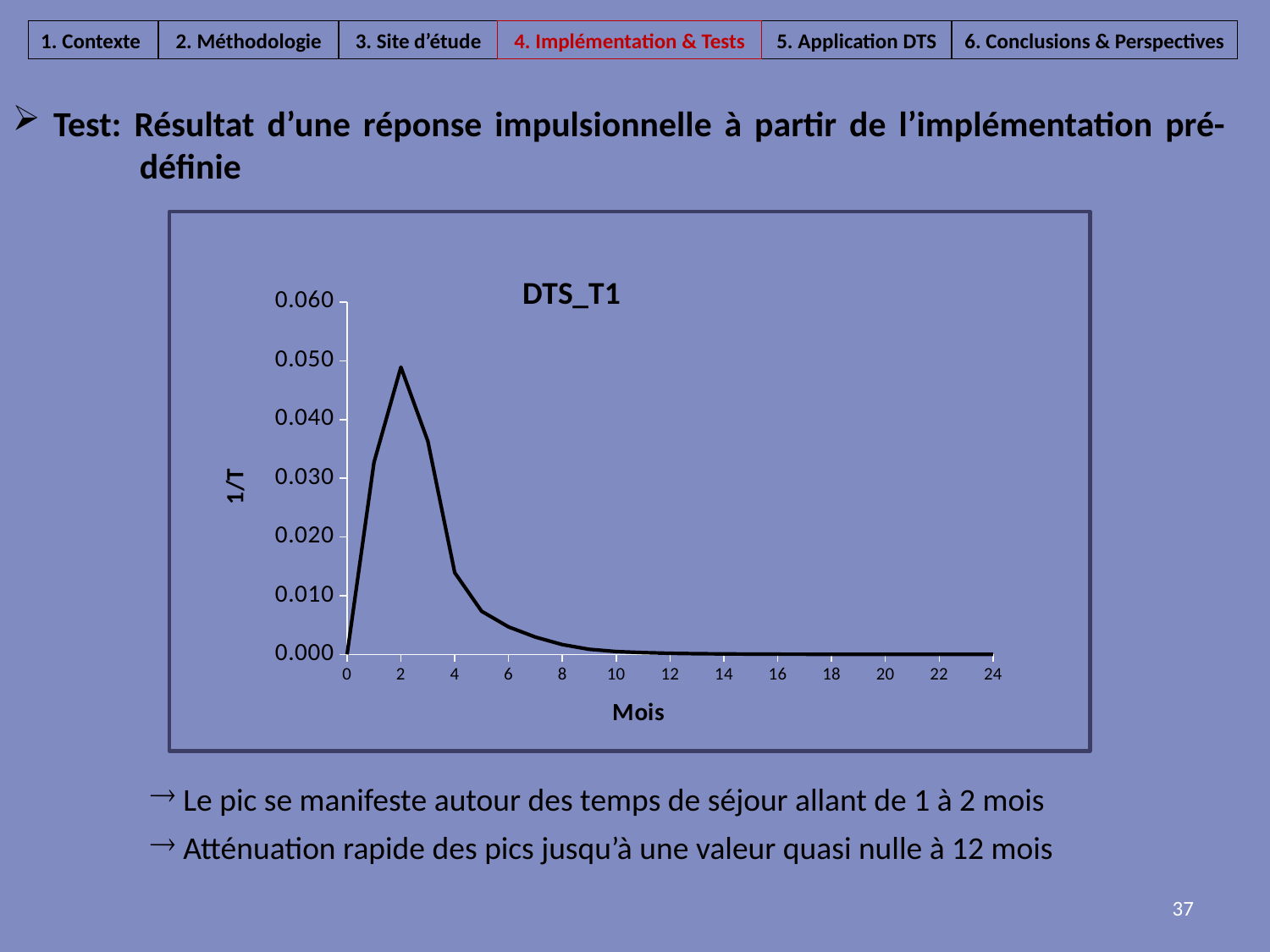
What is the label of the x axis of the chart? Mois What is the title of the chart? DTS_T1 Does the curve rise or fall between 2 and 12 months? fall What type of chart is shown on the slide? line chart Is the value of 1/T at 4 months greater or less than 0.020? less Is the value of 1/T at 1 month greater or less than 0.020? greater Is the value of 1/T at 3 months greater or less than 0.030? greater At which value of Mois does the curve reach its highest point? 2 What is the highest value shown on the y axis of the chart? 0.060 Which is larger, the value of 1/T at 2 months or at 6 months? 2 months